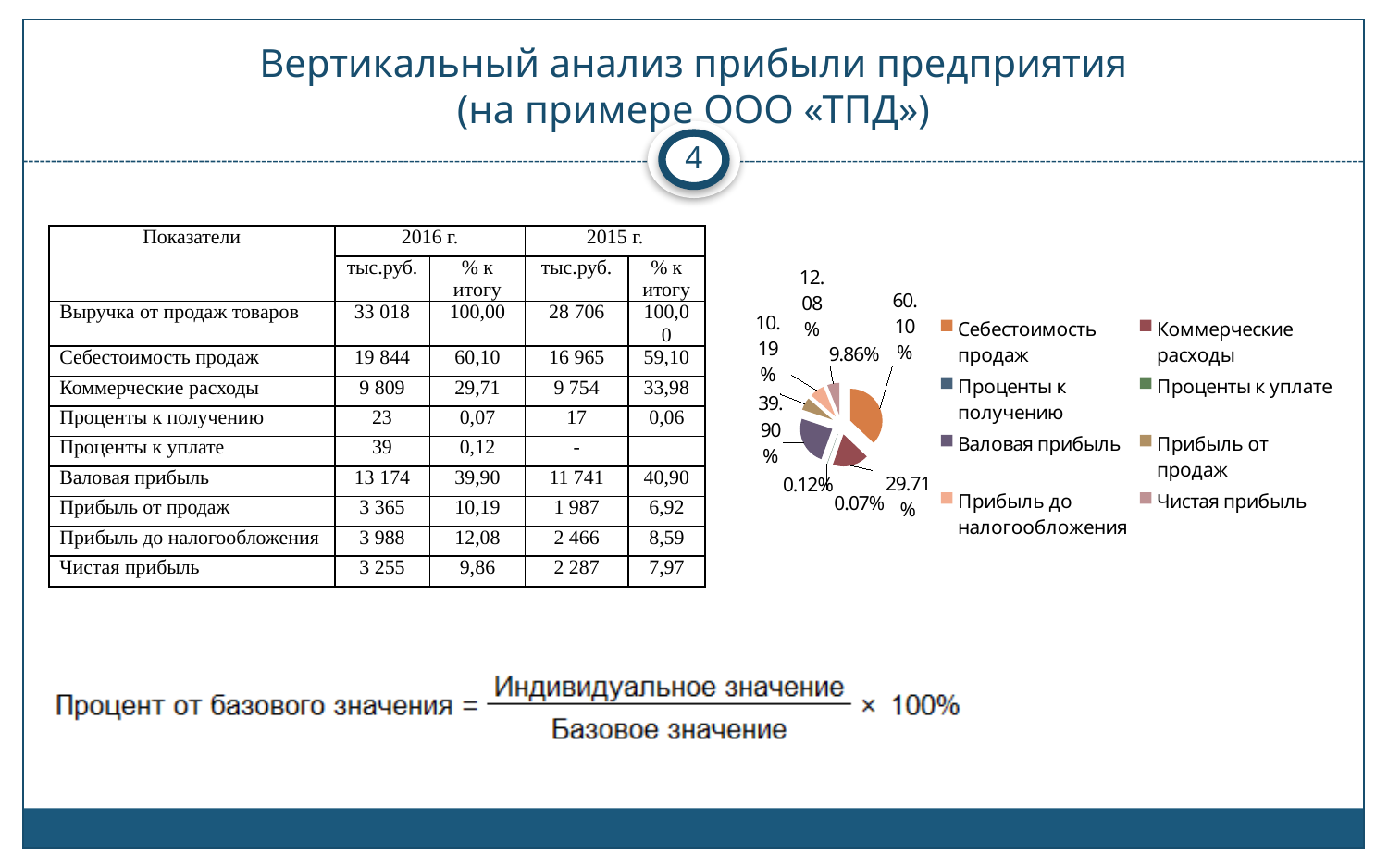
In the pie chart, what is the difference between the labelled values for Себестоимость продаж and Валовая прибыль? 20.20% Which legend category has the smallest slice in the pie chart? Проценты к получению In the pie chart, what is the value labelled for Коммерческие расходы? 29.71% In the pie chart legend, which category is shown in orange? Себестоимость продаж What kind of chart is shown on the right of the slide? pie chart How many slices does the pie chart have? 8 Which legend category has the largest slice in the pie chart? Себестоимость продаж How many entries does the legend of the pie chart list? 8 In the pie chart, what is the value labelled for Себестоимость продаж? 60.10% In the pie chart, which is larger: Прибыль от продаж or Прибыль до налогообложения? Прибыль до налогообложения In the pie chart, what is the value labelled for Валовая прибыль? 39.90% In the pie chart, what is the value labelled for Чистая прибыль? 9.86%